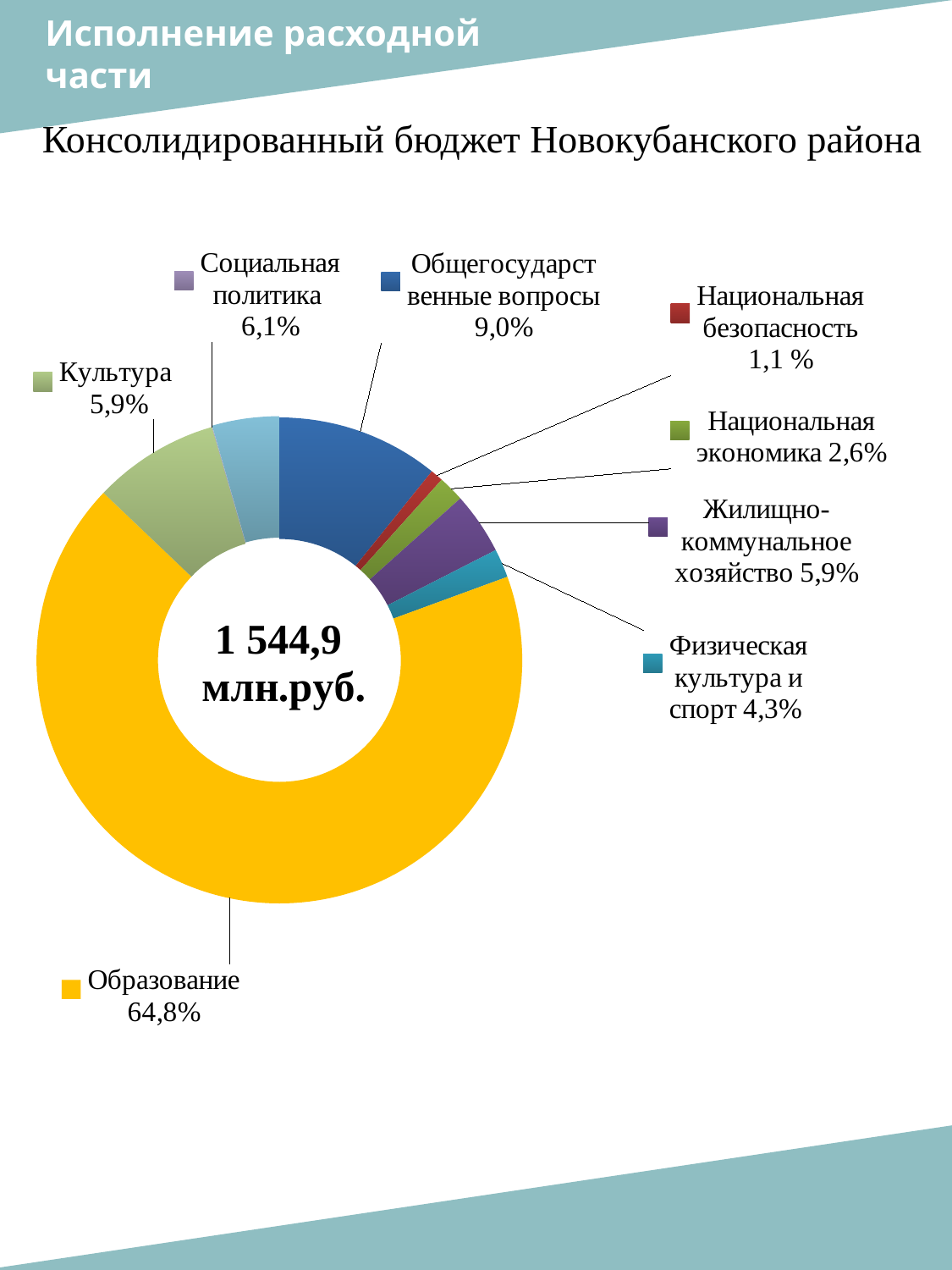
Which category has the smallest share of the budget? Национальная безопасность What is the difference in percentage points between Общегосударственные вопросы and Социальная политика? 2,9 Which has a larger share: Социальная политика or Культура? Социальная политика What kind of chart is shown on the slide? Doughnut (pie) chart What total amount is shown in the centre of the chart? 1 544,9 млн.руб. What share of the budget goes to Национальная экономика? 2,6% How many categories are shown in the chart? 8 What share of the budget goes to Общегосударственные вопросы? 9,0% Which category has the largest share of the budget? Образование What share of the budget goes to Образование? 64,8% What share of the budget goes to Физическая культура и спорт? 4,3% What is the title of the chart? Консолидированный бюджет Новокубанского района